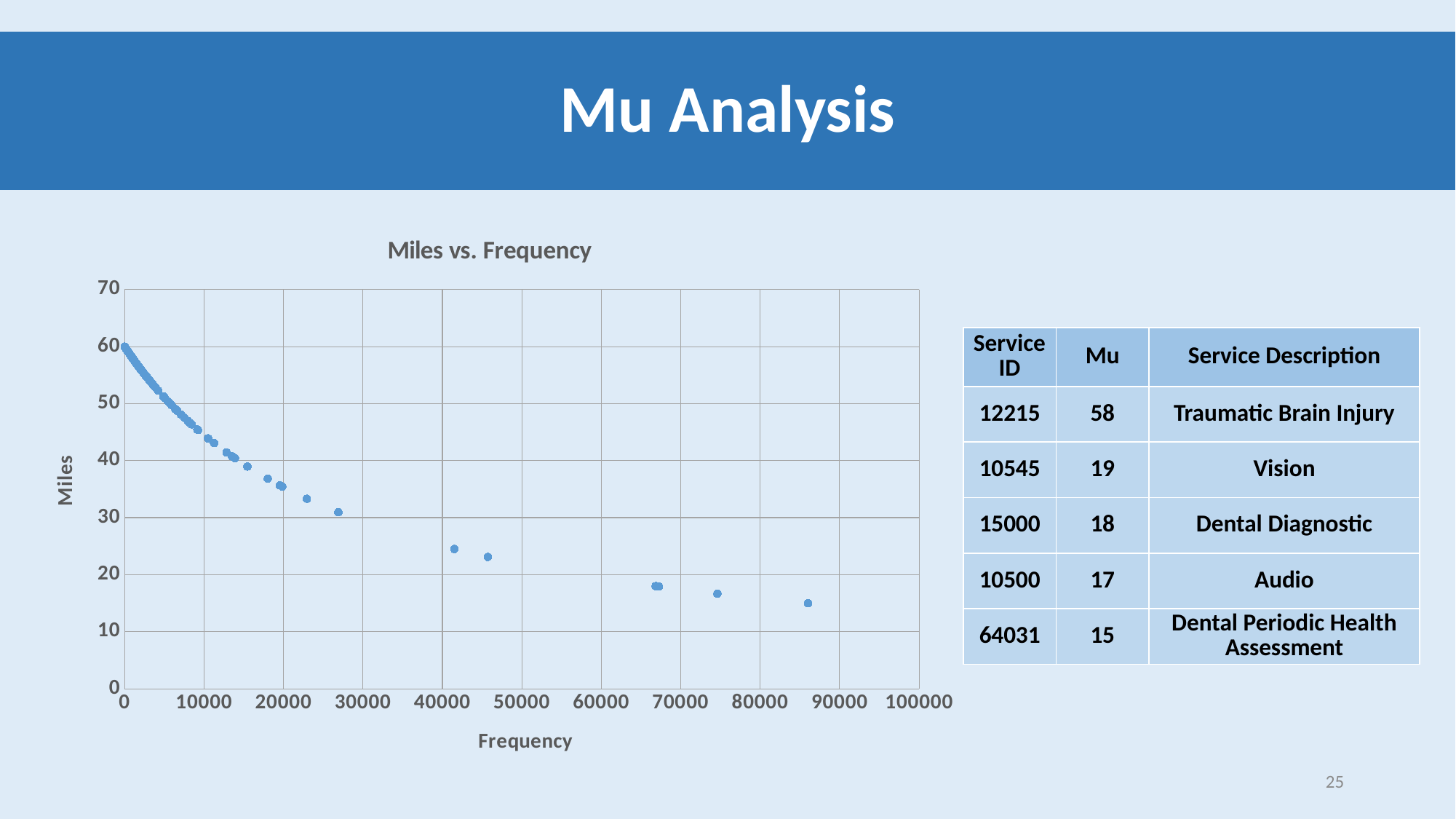
Is the Miles value for the point near a Frequency of 42000 greater or less than 20? greater Is the Miles value for the point near a Frequency of 23000 greater or less than 30? greater What is the label of the vertical axis of the chart? Miles What is the title of the chart? Miles vs. Frequency Are the Miles values for the points with the lowest Frequency (near 0) greater or less than 50? greater Do the Miles values rise or fall as Frequency increases along the x axis? Fall Which has the higher Miles value: the point near a Frequency of 10000 or the point near a Frequency of 75000? The point near a Frequency of 10000 What kind of chart is shown on the slide? Scatter chart